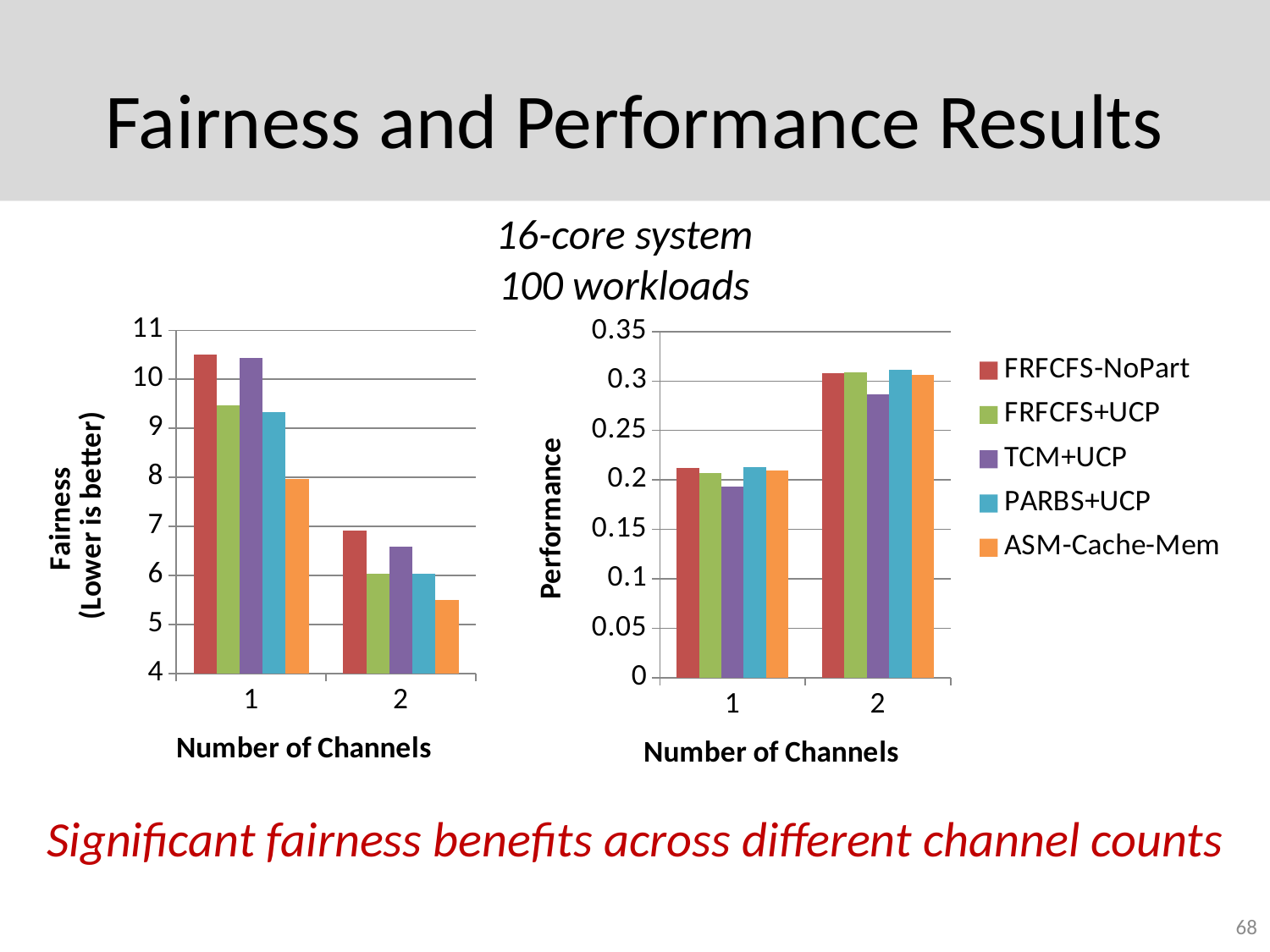
In the Performance chart on the right, do the values rise or fall from 1 channel to 2 channels? rise How many channel-count categories are shown on the x axis of the Performance chart? 2 In the Fairness chart on the left, is the value for FRFCFS+UCP at 2 channels greater or less than 7? less In the Fairness chart on the left, is the value for FRFCFS-NoPart at 1 channel greater or less than 10? greater In the Fairness chart on the left, does the ASM-Cache-Mem value rise or fall from 1 channel to 2 channels? fall What kind of chart is the Fairness chart on the left? bar chart In the Fairness chart on the left, which series has the lowest value at 2 channels? ASM-Cache-Mem In the Performance chart on the right, is the value for TCM+UCP at 1 channel greater or less than 0.2? less How many series does the legend list? 5 In the Performance chart on the right, which series has the lowest value at 2 channels? TCM+UCP In the Fairness chart on the left, which is larger at 2 channels: FRFCFS-NoPart or ASM-Cache-Mem? FRFCFS-NoPart In the Fairness chart on the left, which series has the lowest value at 1 channel? ASM-Cache-Mem